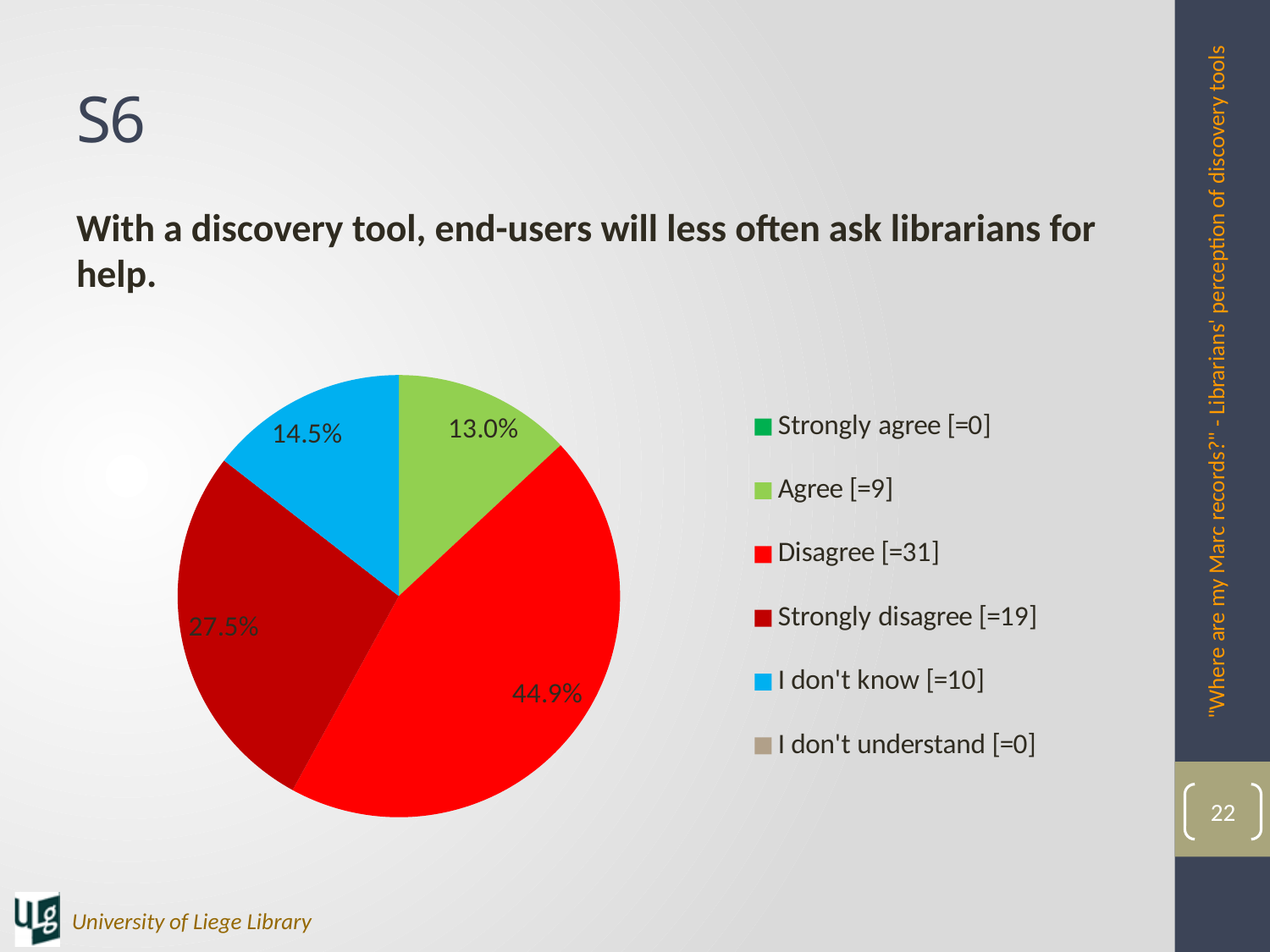
Which response has the largest share of the pie? Disagree What percentage of the pie is the Strongly disagree slice? 27.5% What percentage of the pie is the Disagree slice? 44.9% What is the difference in percentage points between the Disagree and Strongly disagree slices? 17.4 What colour is the Strongly disagree slice? dark red What kind of chart is shown on the slide? pie chart How many entries does the legend list? 6 What percentage of the pie is the Agree slice? 13.0% According to the legend, how many respondents answered Disagree? 31 What percentage of the pie is the I don't know slice? 14.5% Which slice is larger, Strongly disagree or I don't know? Strongly disagree Which of the slices shown in the pie has the smallest share? Agree